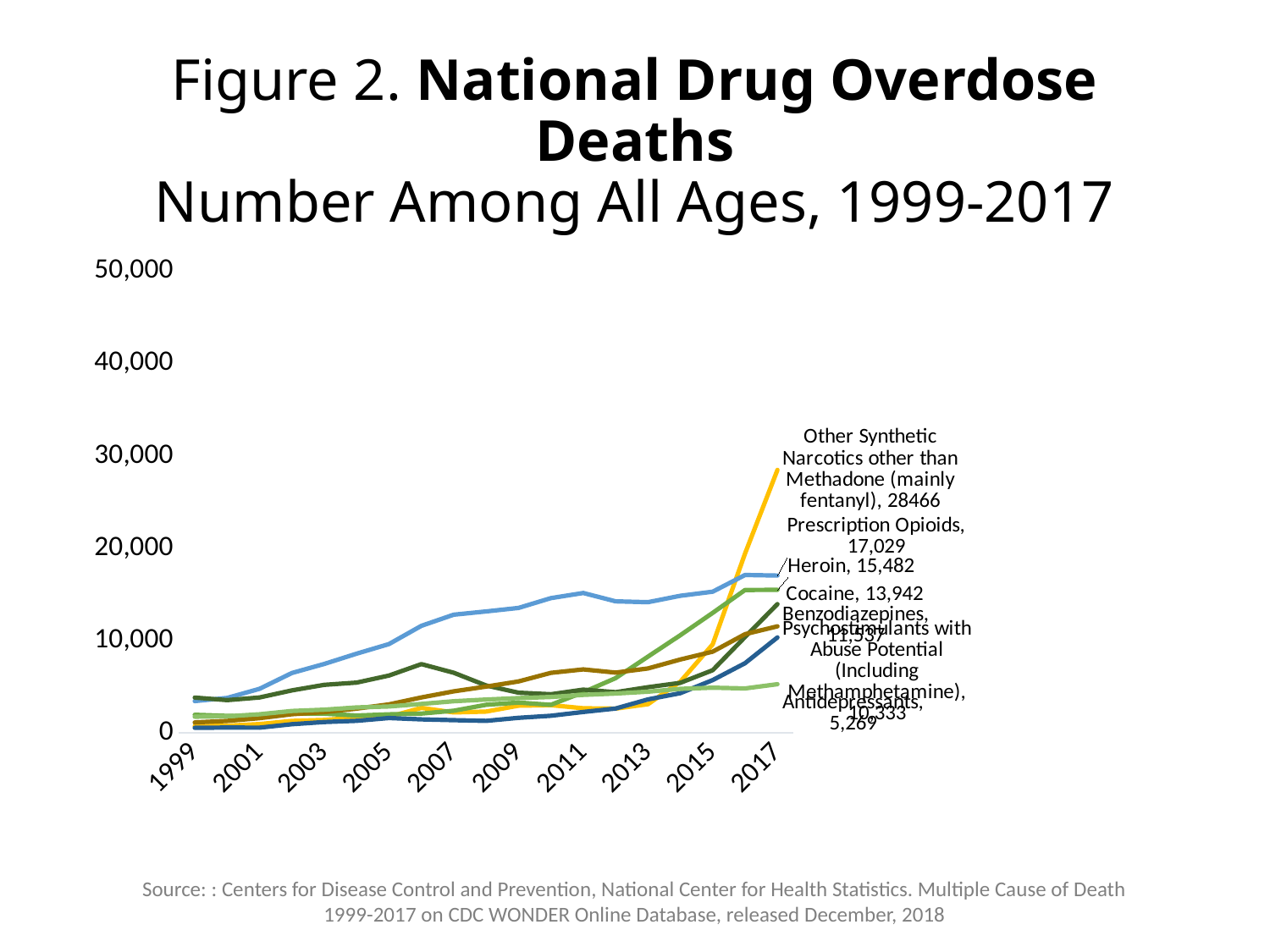
Which labelled drug category has the lowest number of overdose deaths in 2017? Antidepressants What is the 2017 value labelled for Cocaine? 13,942 Does the line for Other Synthetic Narcotics other than Methadone (mainly fentanyl) rise or fall between 2013 and 2017? rise What is the 2017 value labelled for Psychostimulants with Abuse Potential (Including Methamphetamine)? 10,333 What is the 2017 value labelled for Prescription Opioids? 17,029 How many more overdose deaths were attributed to Prescription Opioids than to Heroin in 2017? 1,547 What type of chart is shown on the slide? line chart What is the 2017 value labelled for Antidepressants? 5,269 In 2017, which had more overdose deaths, Cocaine or Heroin? Heroin Which drug category has the highest number of overdose deaths in 2017? Other Synthetic Narcotics other than Methadone (mainly fentanyl) What is the number of Heroin overdose deaths shown for 2017? 15,482 What is the 2017 value labelled for Other Synthetic Narcotics other than Methadone (mainly fentanyl)? 28466